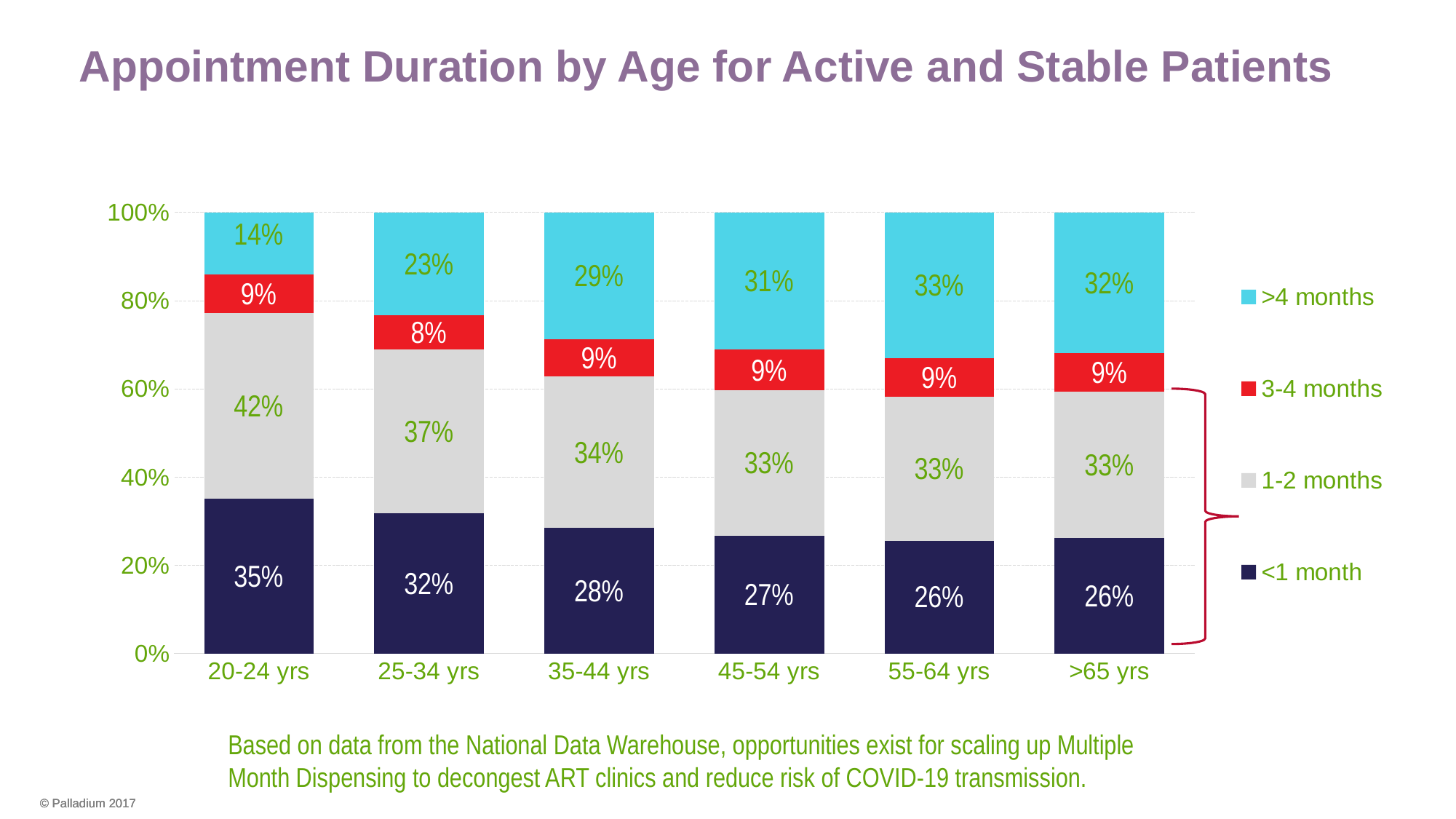
How many age groups are shown on the x axis? 6 Which age group has the highest value for >4 months? 55-64 yrs How many series does the legend list? 4 Which age group has the lowest value for <1 month? 55-64 yrs and >65 yrs What is the value for 3-4 months in the 35-44 yrs age group? 9% What percentage of patients aged 20-24 yrs have appointment durations of <1 month? 35% Does the <1 month value rise or fall as age increases along the x axis? Fall Which is larger: the 1-2 months value for 20-24 yrs or for 35-44 yrs? 20-24 yrs What is the value for 1-2 months in the 25-34 yrs age group? 37% What is the value for >4 months in the >65 yrs age group? 32% What is the difference between the >4 months values for 20-24 yrs and 45-54 yrs? 17 percentage points What kind of chart is shown on the slide? Stacked bar chart